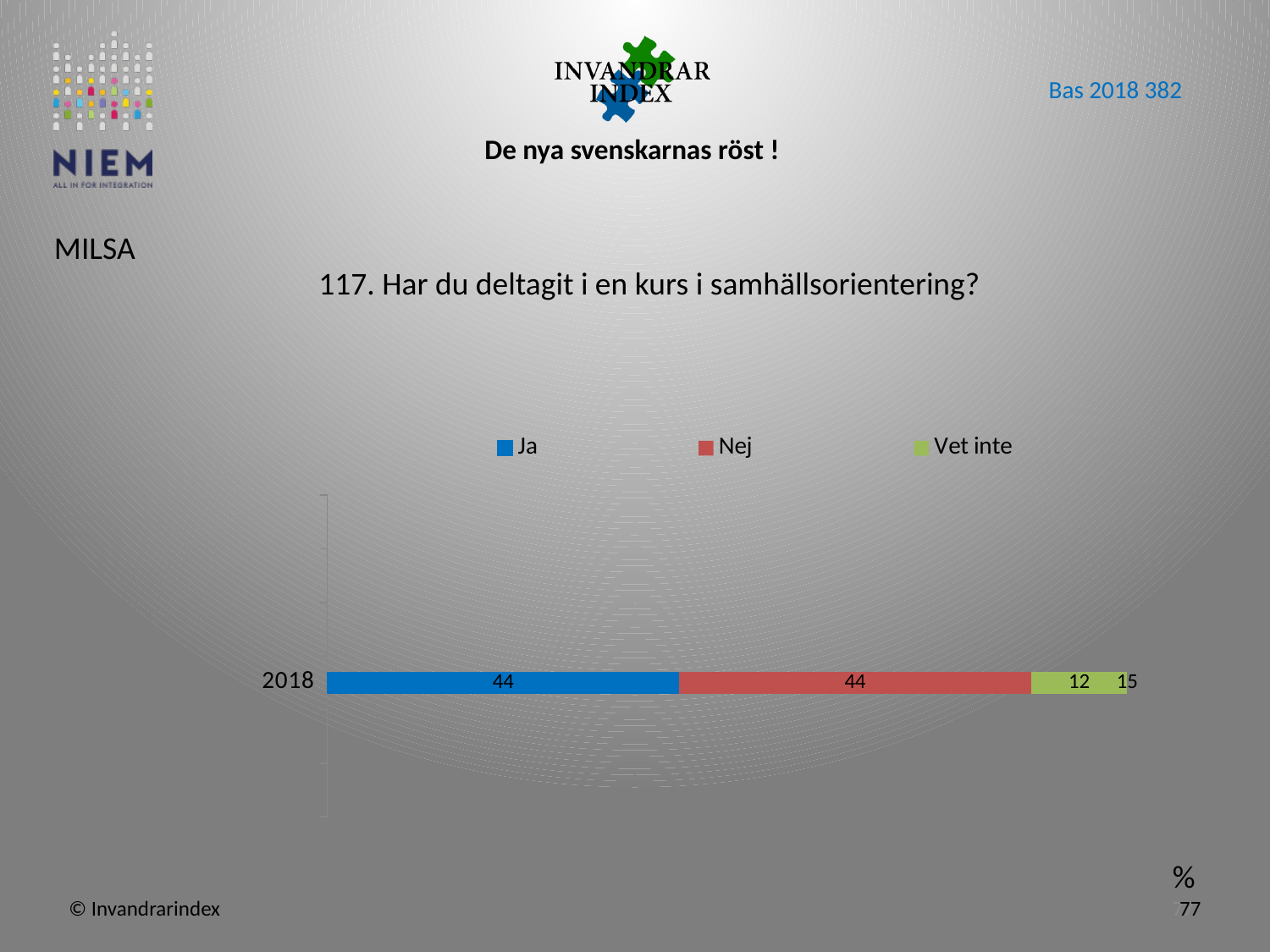
What is the title of the chart? 117. Har du deltagit i en kurs i samhällsorientering? What is the difference between the Ja and Vet inte values in 2018? 32 What kind of chart is shown on the slide? Stacked bar chart Which series has the lowest value in 2018? Vet inte What is the value for Vet inte in 2018? 12 Which is larger in 2018, Ja or Vet inte? Ja What is the value for Ja in 2018? 44 What is the difference between the Nej and Vet inte values in 2018? 32 How many series does the legend list? 3 Which series is shown in blue? Ja How many categories (years) are shown on the chart? 1 What is the value for Nej in 2018? 44